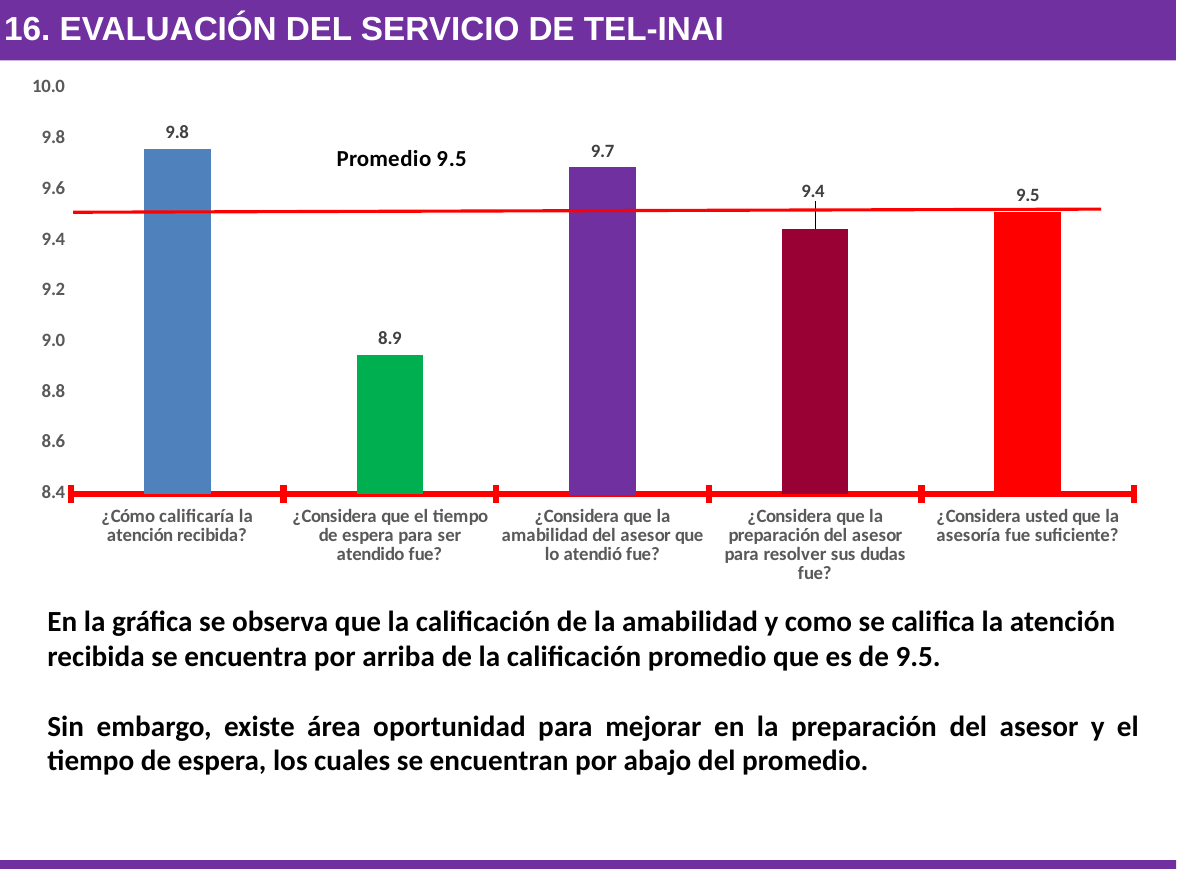
What colour is the bar for "¿Considera que el tiempo de espera para ser atendido fue?"? green What is the value for "¿Cómo calificaría la atención recibida?"? 9.8 What average value (Promedio) is marked by the red horizontal line on the chart? 9.5 What kind of chart is shown on the slide? bar chart Which category has the highest value? ¿Cómo calificaría la atención recibida? Which is larger: the value for "¿Considera que la amabilidad del asesor que lo atendió fue?" or the value for "¿Considera usted que la asesoría fue suficiente?"? ¿Considera que la amabilidad del asesor que lo atendió fue? How many categories are shown in the chart? 5 What is the difference between the value for "¿Cómo calificaría la atención recibida?" and the value for "¿Considera que el tiempo de espera para ser atendido fue?"? 0.9 What is the value for "¿Considera que la preparación del asesor para resolver sus dudas fue?"? 9.4 What is the value for "¿Considera que el tiempo de espera para ser atendido fue?"? 8.9 Is the value for "¿Considera que el tiempo de espera para ser atendido fue?" greater or less than 9.0? less Which category has the lowest value? ¿Considera que el tiempo de espera para ser atendido fue?